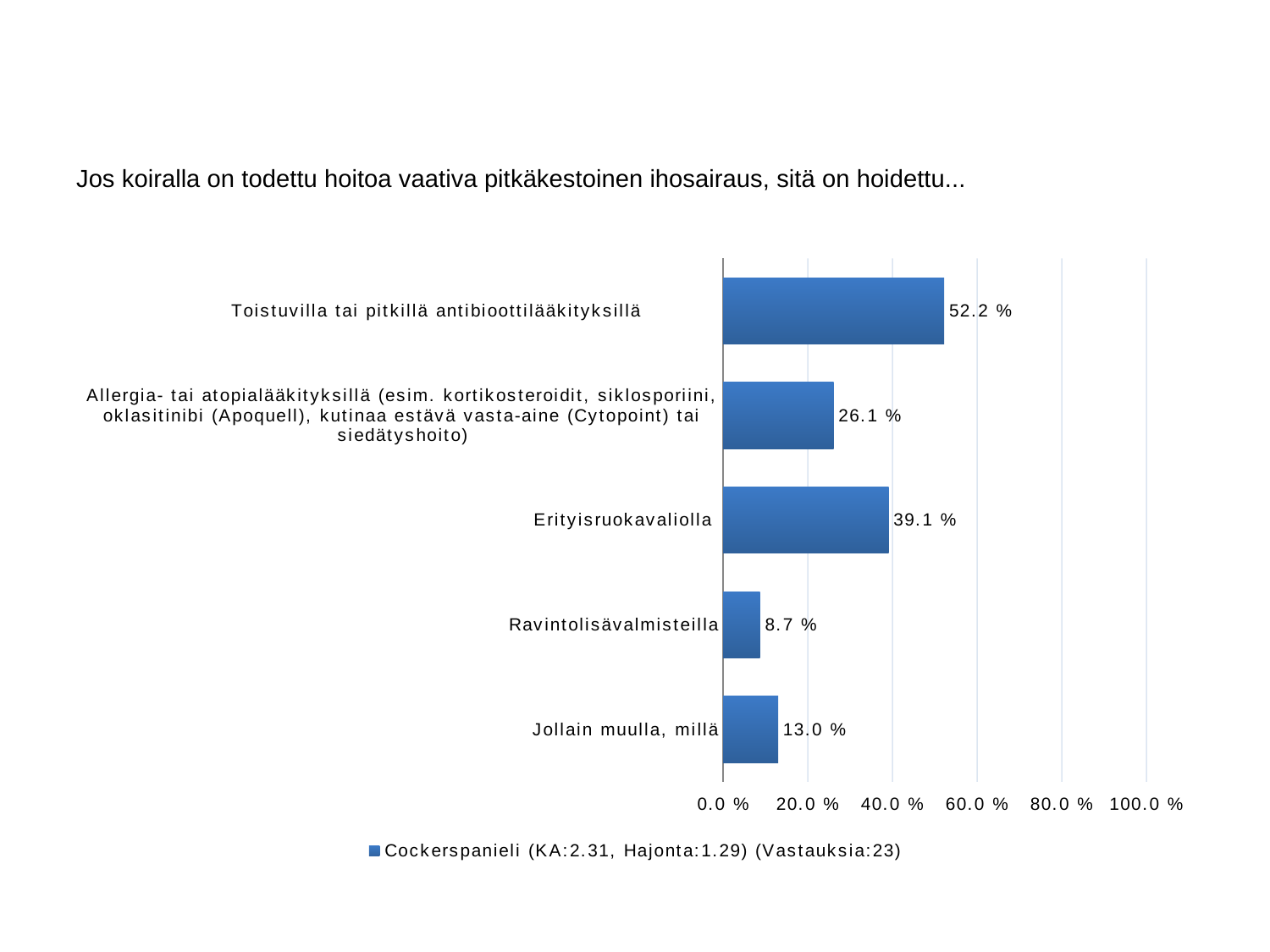
What is the value for "Erityisruokavaliolla"? 39.1 % How many categories are shown in the chart? 5 What is the value for "Jollain muulla, millä"? 13.0 % What series does the legend list? Cockerspanieli (KA:2.31, Hajonta:1.29) (Vastauksia:23) What is the value for "Ravintolisävalmisteilla"? 8.7 % Which is larger, the value for "Erityisruokavaliolla" or the value for the allergy/atopy medication category (Allergia- tai atopialääkityksillä)? Erityisruokavaliolla What kind of chart is shown on the slide? bar chart What is the value for "Toistuvilla tai pitkillä antibioottilääkityksillä"? 52.2 % What is the difference between the values for "Toistuvilla tai pitkillä antibioottilääkityksillä" and "Erityisruokavaliolla"? 13.1 % Which category has the highest value? Toistuvilla tai pitkillä antibioottilääkityksillä Which category has the lowest value? Ravintolisävalmisteilla Is the value for "Toistuvilla tai pitkillä antibioottilääkityksillä" greater or less than 40.0 %? greater